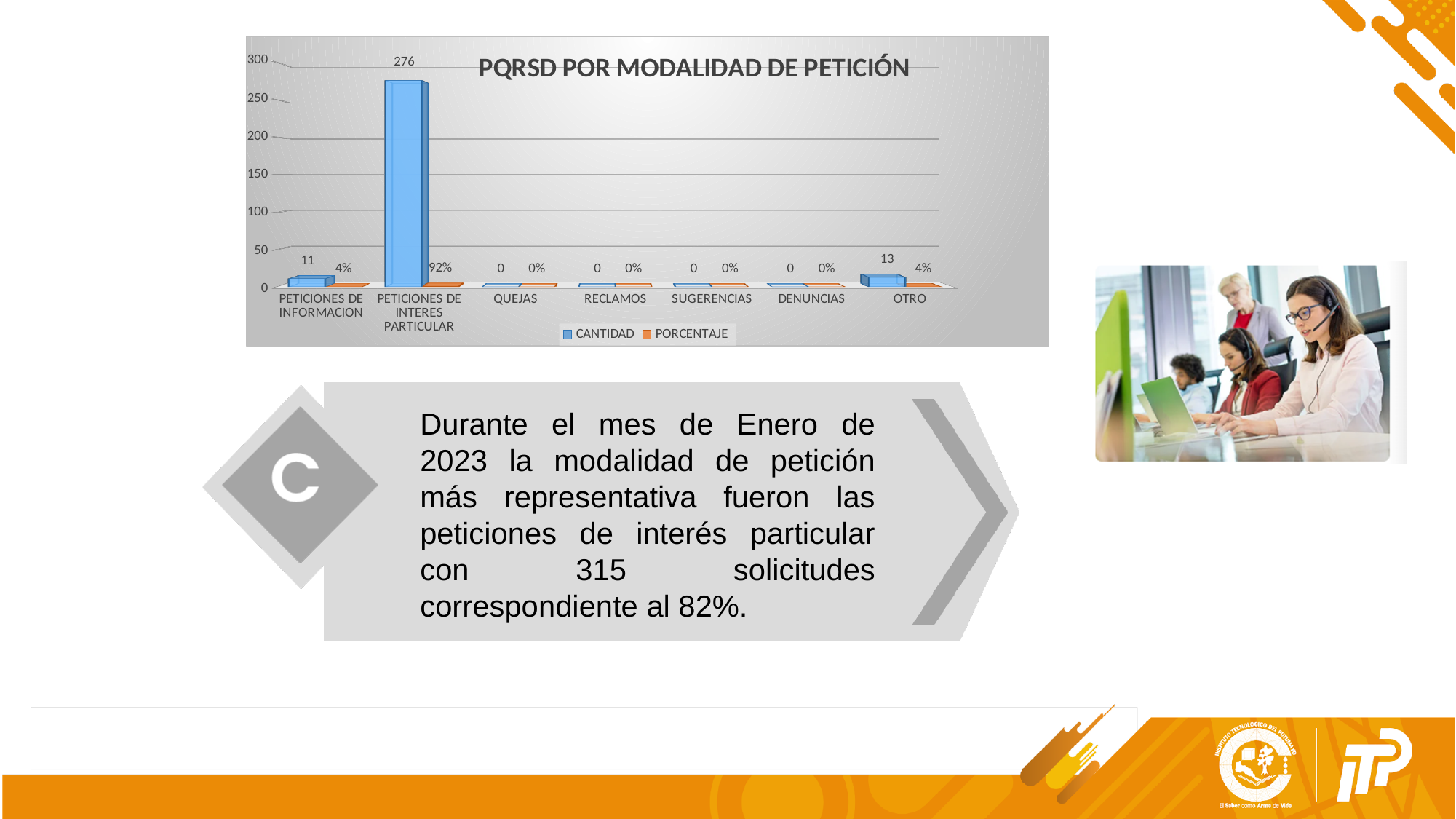
What is the CANTIDAD value for PETICIONES DE INFORMACION? 11 How many categories are shown on the x axis? 7 How many series does the legend list? 2 What is the difference in CANTIDAD between PETICIONES DE INTERES PARTICULAR and OTRO? 263 What is the CANTIDAD value for PETICIONES DE INTERES PARTICULAR? 276 What PORCENTAJE is shown for OTRO? 4% Which has a larger CANTIDAD, PETICIONES DE INFORMACION or OTRO? OTRO What is the CANTIDAD value for OTRO? 13 What PORCENTAJE is shown for PETICIONES DE INTERES PARTICULAR? 92% What is the title of the chart? PQRSD POR MODALIDAD DE PETICIÓN Which category has the highest CANTIDAD? PETICIONES DE INTERES PARTICULAR Is the CANTIDAD for PETICIONES DE INTERES PARTICULAR greater or less than 250? greater